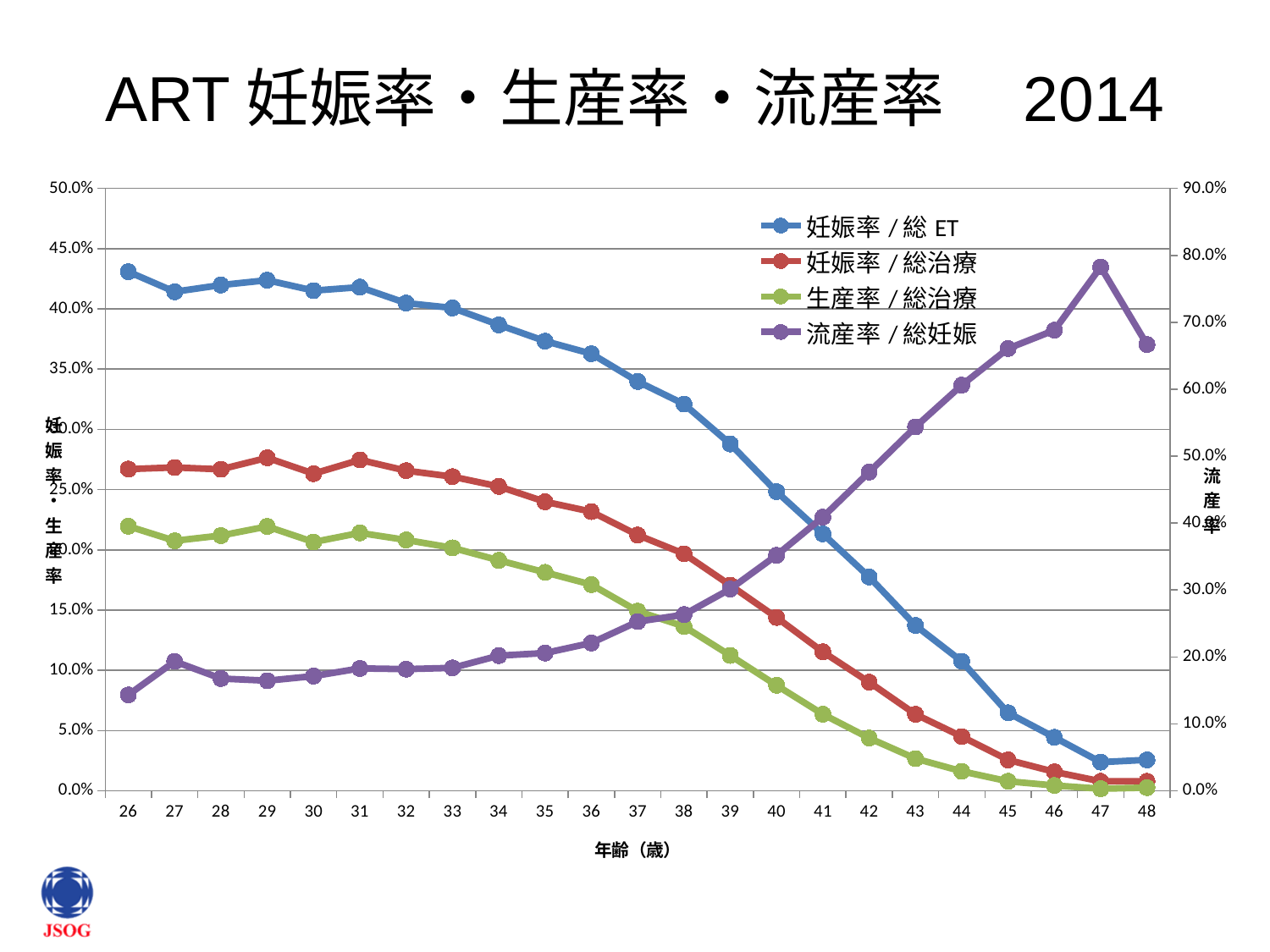
At which age is the 流産率 / 総妊娠 series highest? 47 Is the value of 妊娠率 / 総 ET at age 26 greater or less than 40.0%? greater How many series does the legend list? 4 At age 40, which is larger: 妊娠率 / 総 ET or 妊娠率 / 総治療? 妊娠率 / 総 ET Is the value of 流産率 / 総妊娠 at age 47 greater or less than 70.0% on the right axis? greater What kind of chart is shown on the slide? line chart Is the value of 妊娠率 / 総 ET at age 48 greater or less than 5.0%? less Does the 妊娠率 / 総 ET series rise or fall as age increases from 26 to 48? fall Does the 流産率 / 総妊娠 series generally rise or fall as age increases from 26 to 47? rise What is the label of the x axis? 年齢（歳） What is the title of the chart on the slide? ART 妊娠率・生産率・流産率 2014 How many age categories are plotted along the x axis? 23